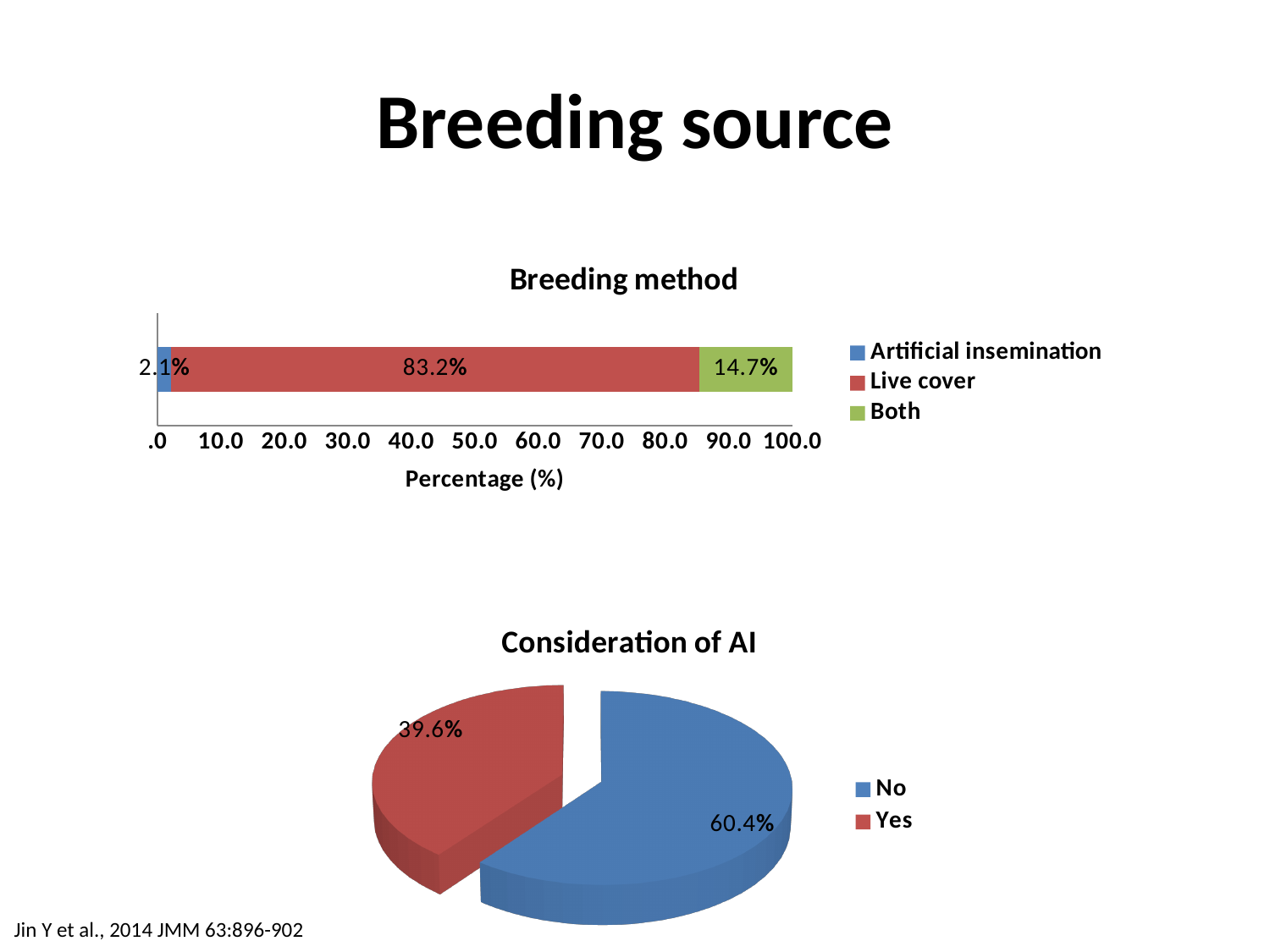
In the 'Breeding method' chart, what percentage is shown for Artificial insemination? 2.1% In the 'Breeding method' chart, which breeding method has the lowest percentage? Artificial insemination In the 'Breeding method' chart, how many series does the legend list? 3 In the 'Consideration of AI' chart, what share of the pie is 'No'? 60.4% In the 'Consideration of AI' chart, what share of the pie is 'Yes'? 39.6% In the 'Breeding method' chart, what percentage is shown for Live cover? 83.2% In the 'Consideration of AI' chart, which is larger, 'No' or 'Yes'? No In the 'Breeding method' chart, what percentage is shown for Both? 14.7% In the 'Breeding method' chart, which breeding method has the highest percentage? Live cover In the 'Breeding method' chart, what is the label of the horizontal axis? Percentage (%) In the 'Breeding method' chart, what is the difference between the Live cover and Both percentages? 68.5% What kind of chart is the 'Breeding method' chart? Stacked bar chart